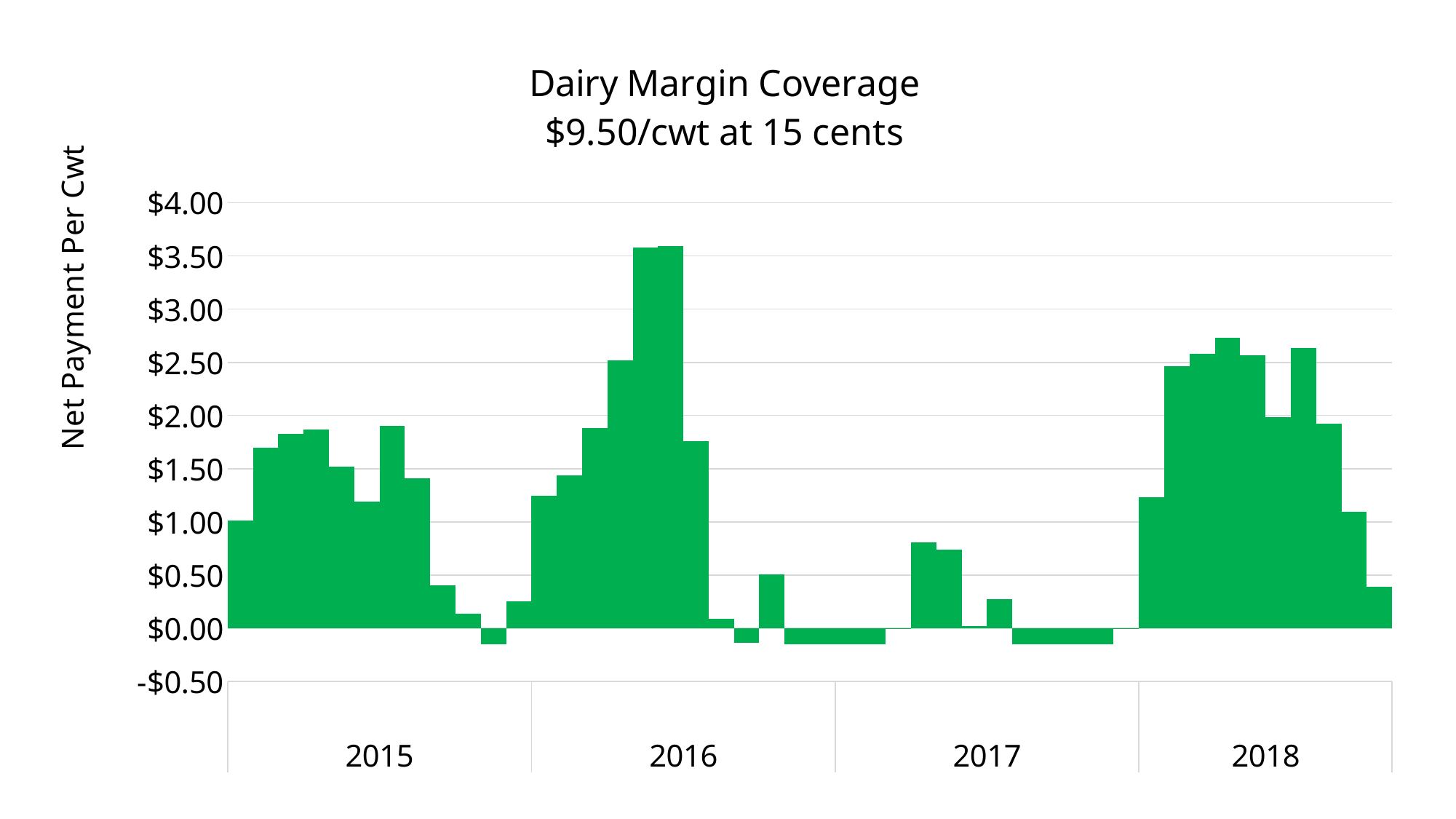
In which year does the chart reach its highest net payment per cwt? 2016 What is the label on the vertical axis of the chart? Net Payment Per Cwt What type of chart is shown on the slide? bar chart How many years are labelled along the horizontal axis of the chart? 4 Which year has the lowest peak net payment per cwt in the chart? 2017 What is the highest value shown on the vertical axis of the chart? $4.00 Is the highest bar in 2016 greater or less than $3.00? greater Which year has a higher peak net payment, 2015 or 2018? 2018 Is the highest bar in 2015 greater or less than $2.00? less Is the highest bar in 2017 greater or less than $1.00? less What is the title of the chart? Dairy Margin Coverage $9.50/cwt at 15 cents